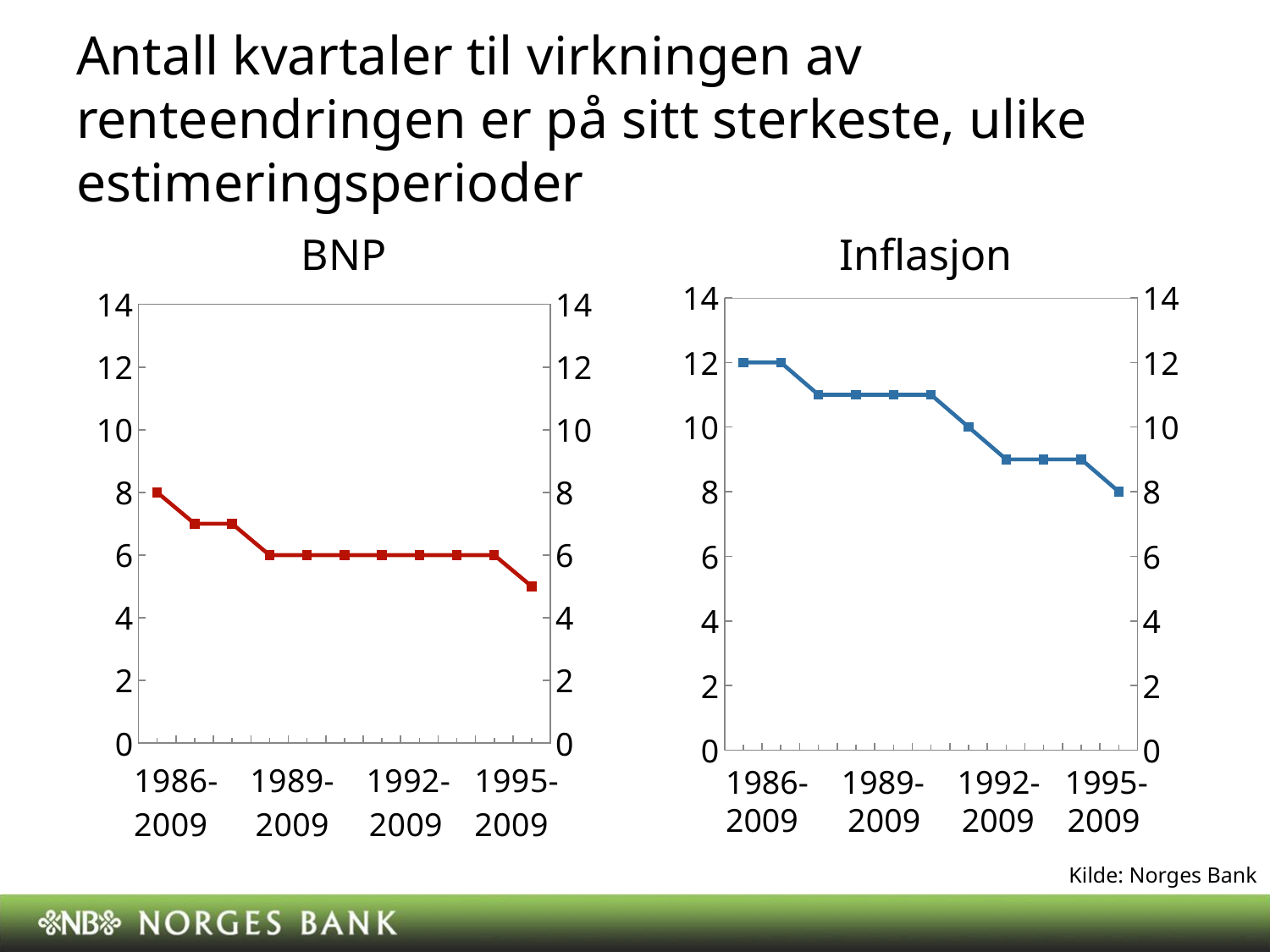
In the BNP chart, what is the difference between the values for 1986-2009 and 1989-2009? 2 What source is cited for the charts on the slide? Norges Bank In the Inflasjon chart, is the value for 1989-2009 greater or less than 10? greater In the BNP chart, what is the value for 1986-2009? 8 What kind of chart is the Inflasjon chart? line chart In the Inflasjon chart, what is the value for 1986-2009? 12 In the BNP chart, is the value for 1995-2009 greater or less than 8? less For the 1986-2009 period, which chart shows the larger value, BNP or Inflasjon? Inflasjon In the BNP chart, which labelled estimation period has the highest value? 1986-2009 In the BNP chart, what is the value for 1992-2009? 6 In the Inflasjon chart, do the values rise or fall as the estimation periods move from 1986-2009 to 1995-2009? fall In the Inflasjon chart, what is the value for 1992-2009? 10